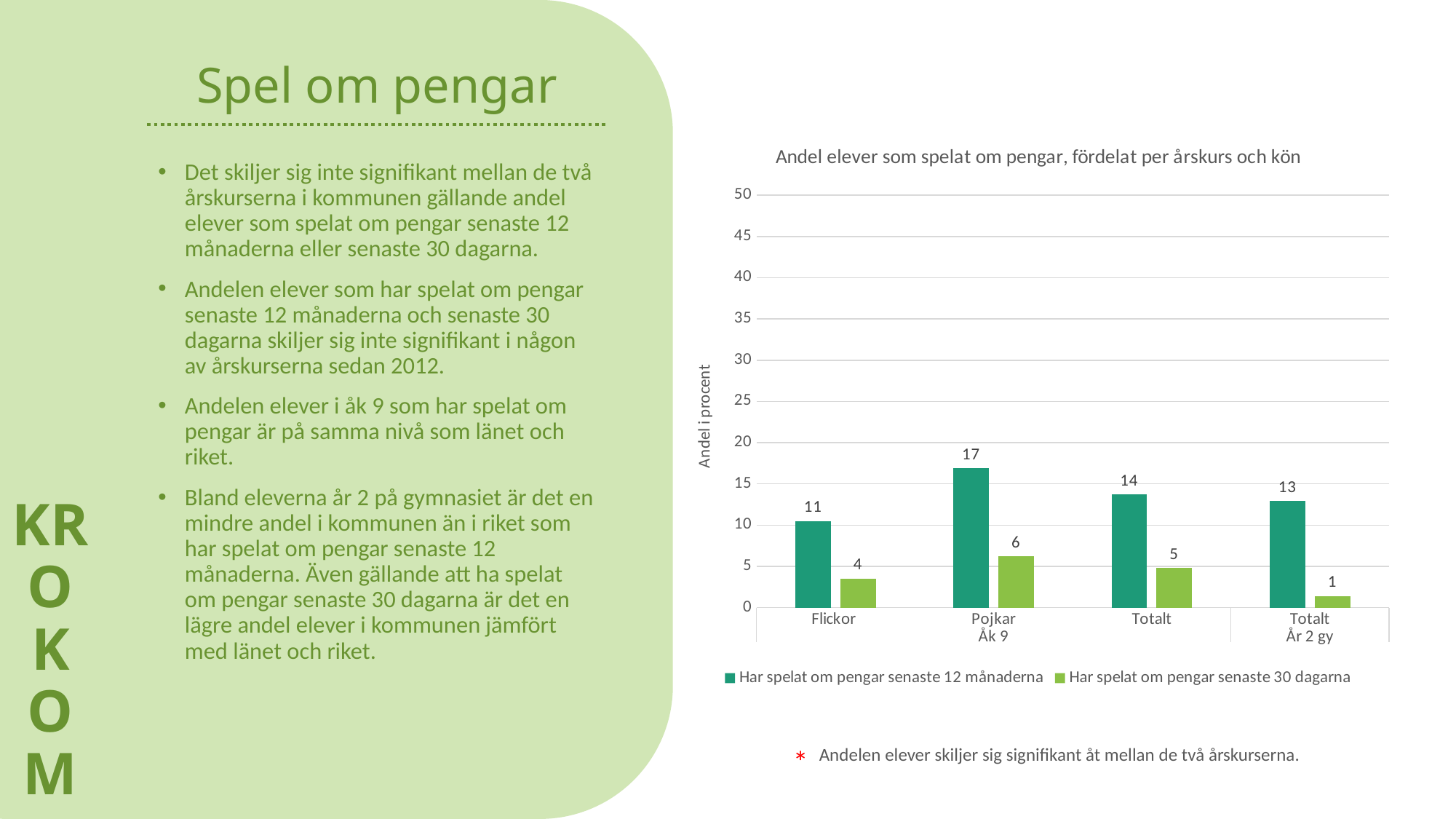
What is the difference between the 12-month values for Totalt Åk 9 and Totalt År 2 gy? 1 What is the value for Flickor (Åk 9) in the series 'Har spelat om pengar senaste 30 dagarna'? 4 Which category has the highest value in the series 'Har spelat om pengar senaste 12 månaderna'? Pojkar (Åk 9) What is the difference between the 12-month value and the 30-day value for Pojkar (Åk 9)? 11 Is the 12-month value for Flickor (Åk 9) greater or less than 15? less Which category has the lowest value in the series 'Har spelat om pengar senaste 30 dagarna'? Totalt År 2 gy What kind of chart is shown on the slide? Bar chart Which is larger: the 30-day value for Pojkar (Åk 9) or the 30-day value for Totalt Åk 9? Pojkar (Åk 9) How many series does the legend list? 2 How many categories are shown on the x axis? 4 What is the value for Totalt År 2 gy in the series 'Har spelat om pengar senaste 12 månaderna'? 13 What is the value for Pojkar (Åk 9) in the series 'Har spelat om pengar senaste 12 månaderna'? 17